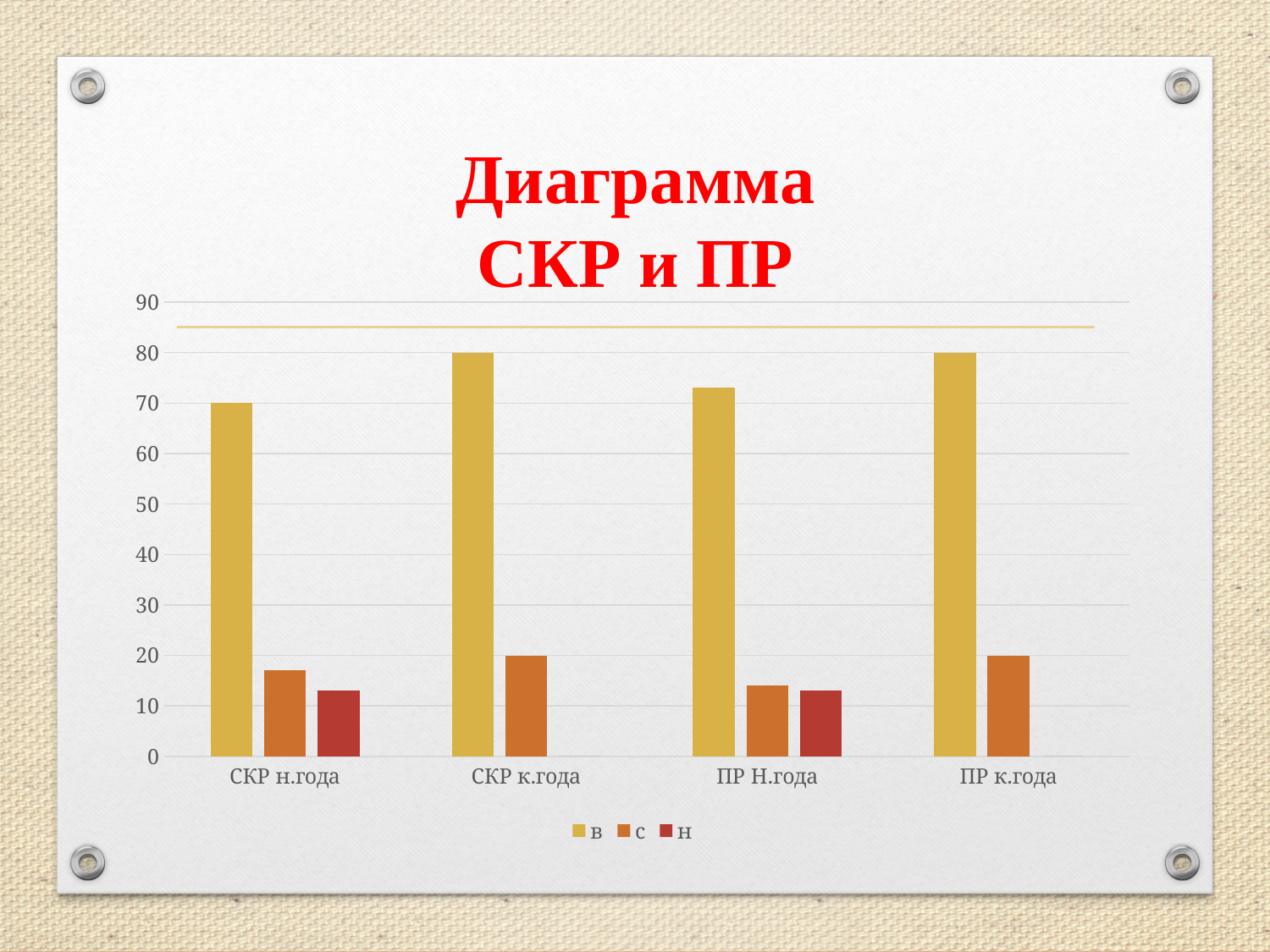
Which is larger: the value of series в for СКР к.года or for СКР н.года? СКР к.года Is the value of series н for СКР н.года greater or less than 10? greater How many categories are shown on the x axis of the chart? 4 What is the value of series с for ПР к.года? 20 What are the legend entries of the chart? в, с, н What is the difference between the value of series в for СКР к.года and for СКР н.года? 10 Is the value of series в for ПР Н.года greater or less than 70? greater What is the value of series в for СКР к.года? 80 What is the value of series в for СКР н.года? 70 What kind of chart is shown on the slide? bar chart Is the value of series с for СКР н.года greater or less than 20? less How many series does the legend list? 3